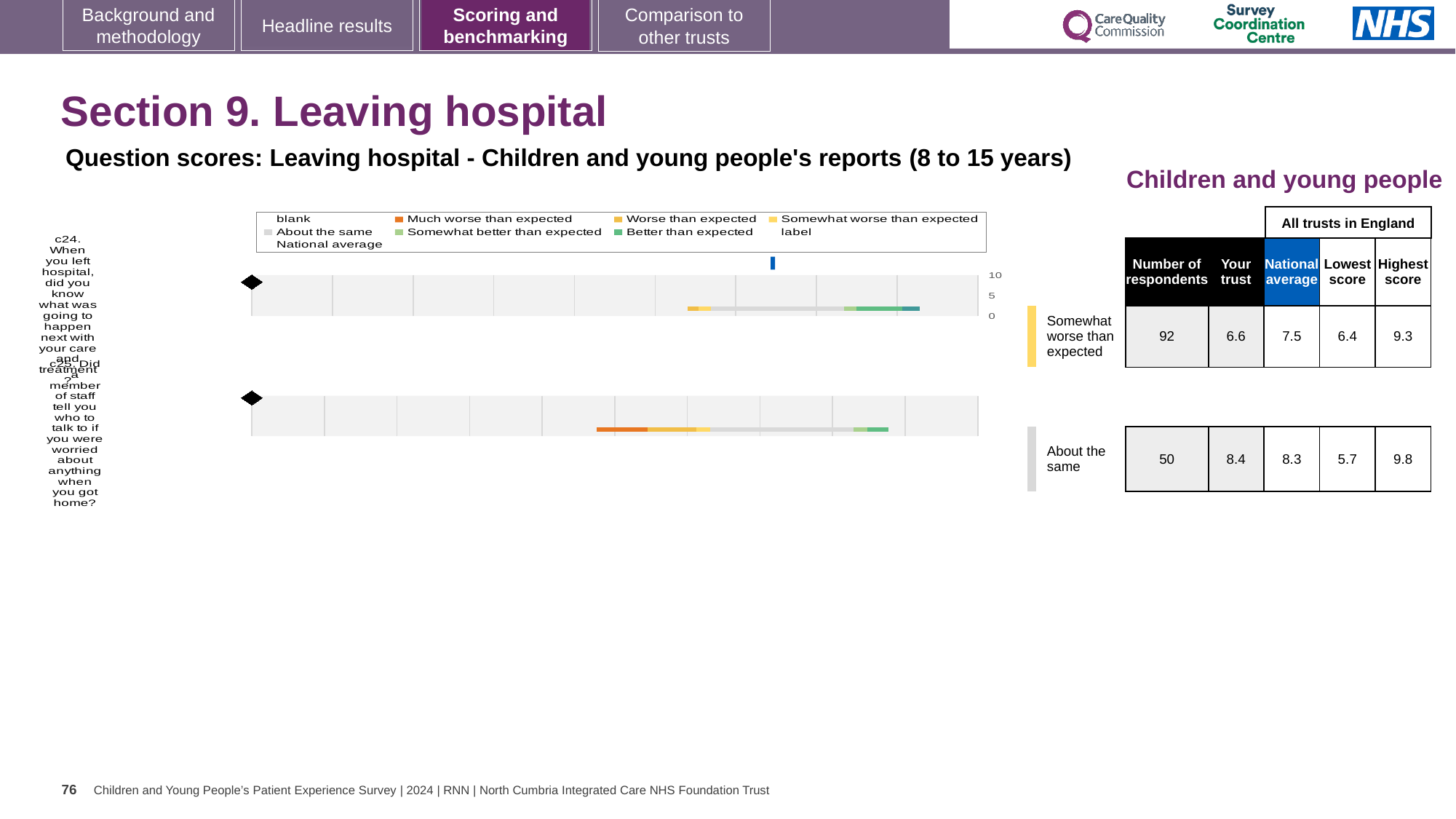
Which question has the higher 'Your trust' score, c24 or c25? c25 What is the 'Your trust' score for question c24 (When you left hospital, did you know what was going to happen next with your care and treatment?)? 6.6 What is the national average score for question c24? 7.5 What is the 'Your trust' score for question c25 (Did a member of staff tell you who to talk to if you were worried about anything when you got home?)? 8.4 What is the difference between the highest and lowest scores for question c25? 4.1 How many respondents answered question c24? 92 What is the difference between the national average and the trust score for question c24? 0.9 How many survey questions (bars) are plotted in the chart? 2 What colour does the legend use for 'Much worse than expected'? orange What is the highest score across all trusts in England for question c25? 9.8 Which benchmarking category is question c24 rated as? Somewhat worse than expected What kind of chart is shown on the slide? bar chart